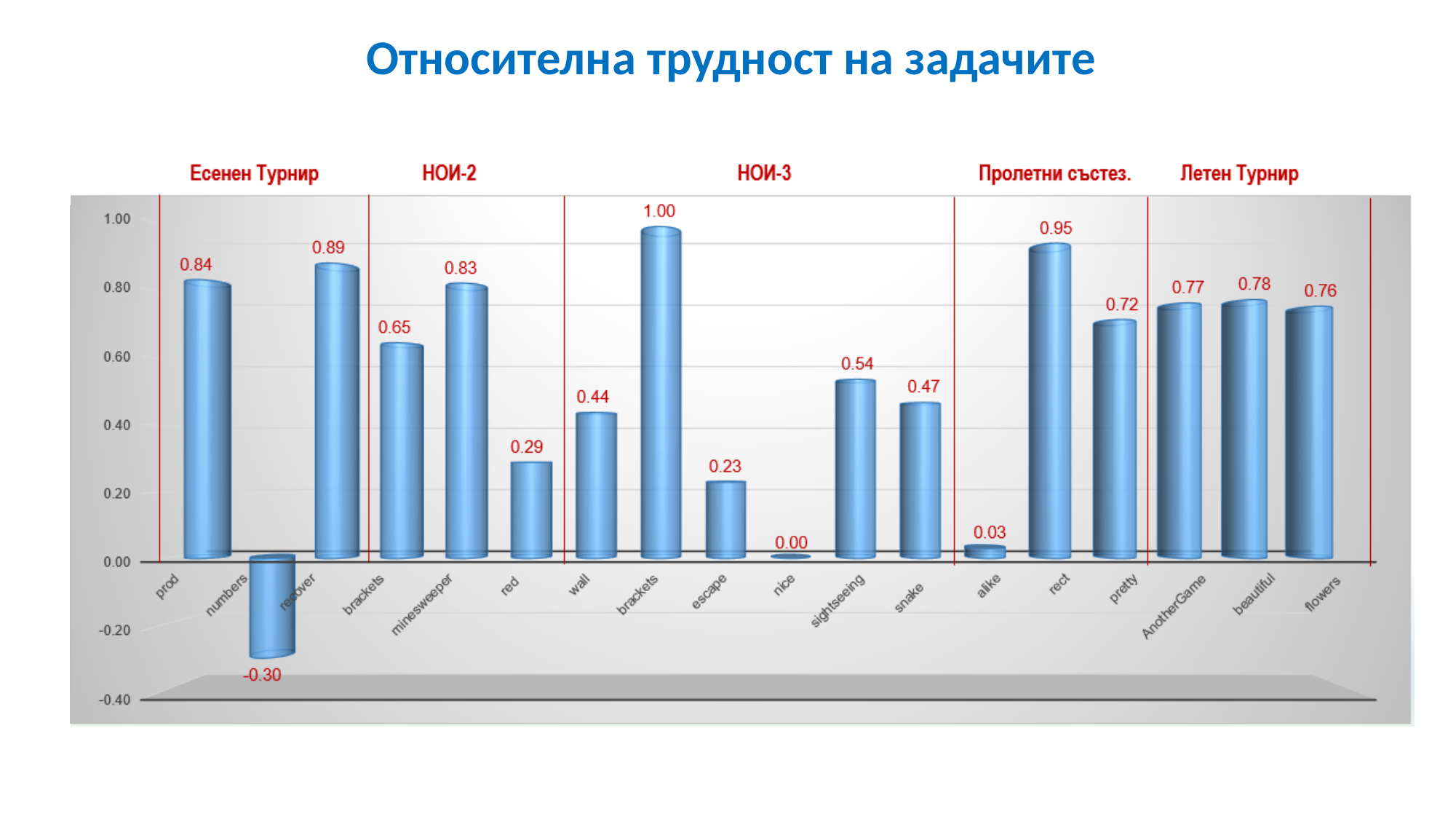
How many bars are plotted on the chart? 18 What is the value for rect? 0.95 What is the value for prod? 0.84 What is the value for numbers? -0.30 Which is larger, the value for rect or the value for recover? rect Which task has the lowest value on the chart? numbers What kind of chart is shown on the slide? bar chart Is the value for minesweeper greater or less than 0.60? greater What is the difference between the values for sightseeing and snake? 0.07 What is the difference between the values for recover and prod? 0.05 Which task has the highest value on the chart? brackets (in НОИ-3), 1.00 What is the value for alike? 0.03